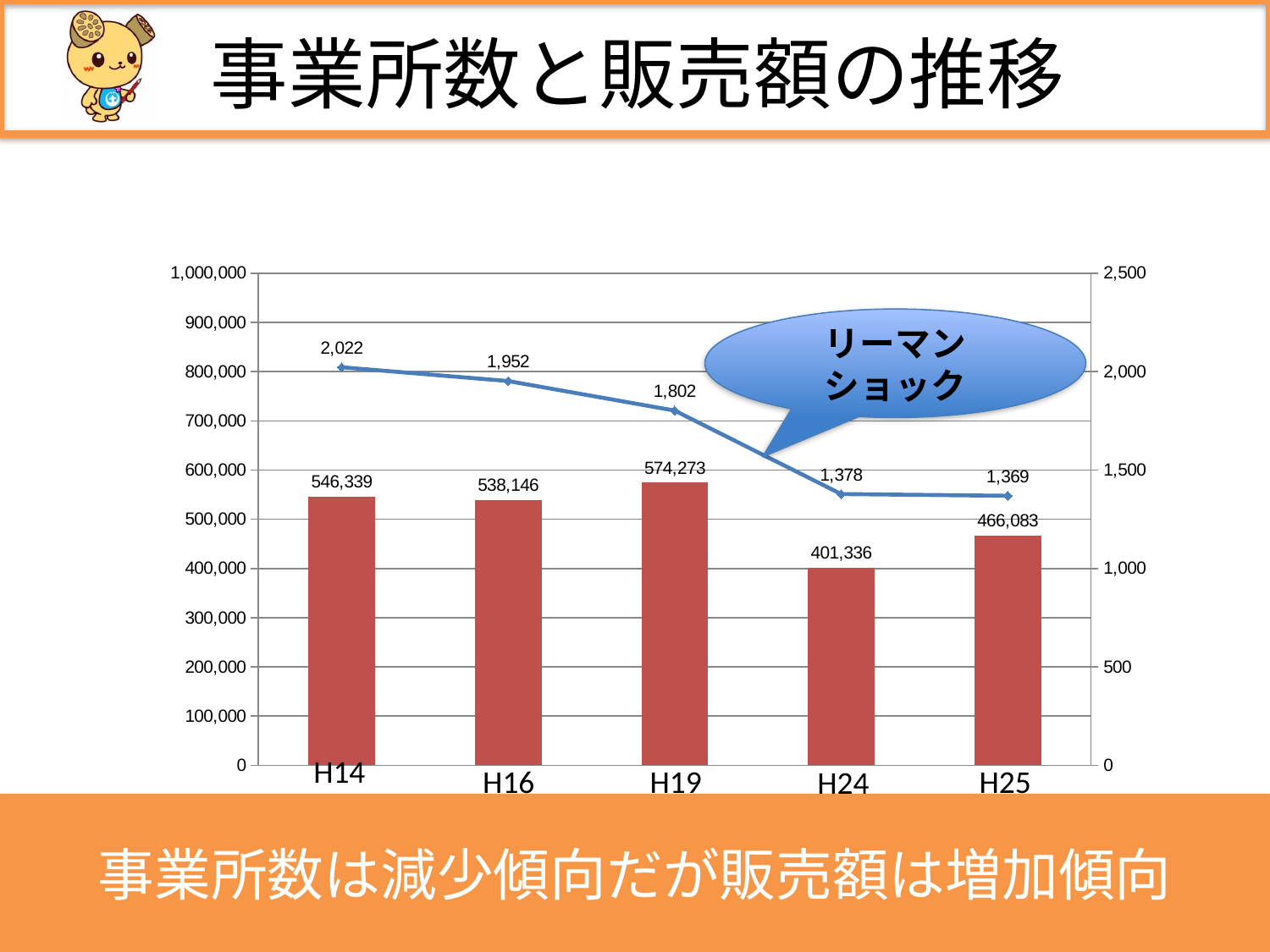
By how much does the line value at H14 exceed the line value at H25? 653 What text is written in the blue callout on the chart? リーマンショック Which bar is taller, H14 or H16? H14 What is the difference between the bar values for H19 and H24? 172,937 Which category has the tallest bar? H19 Do the values of the line series rise or fall from H14 to H25? fall How many categories are shown on the x axis? 5 What is the value of the bar for H19? 574,273 What is the value of the line series at H14? 2,022 What is the value of the line series at H25? 1,369 Which category has the shortest bar? H24 What kind of chart is shown on the slide? bar chart combined with a line chart